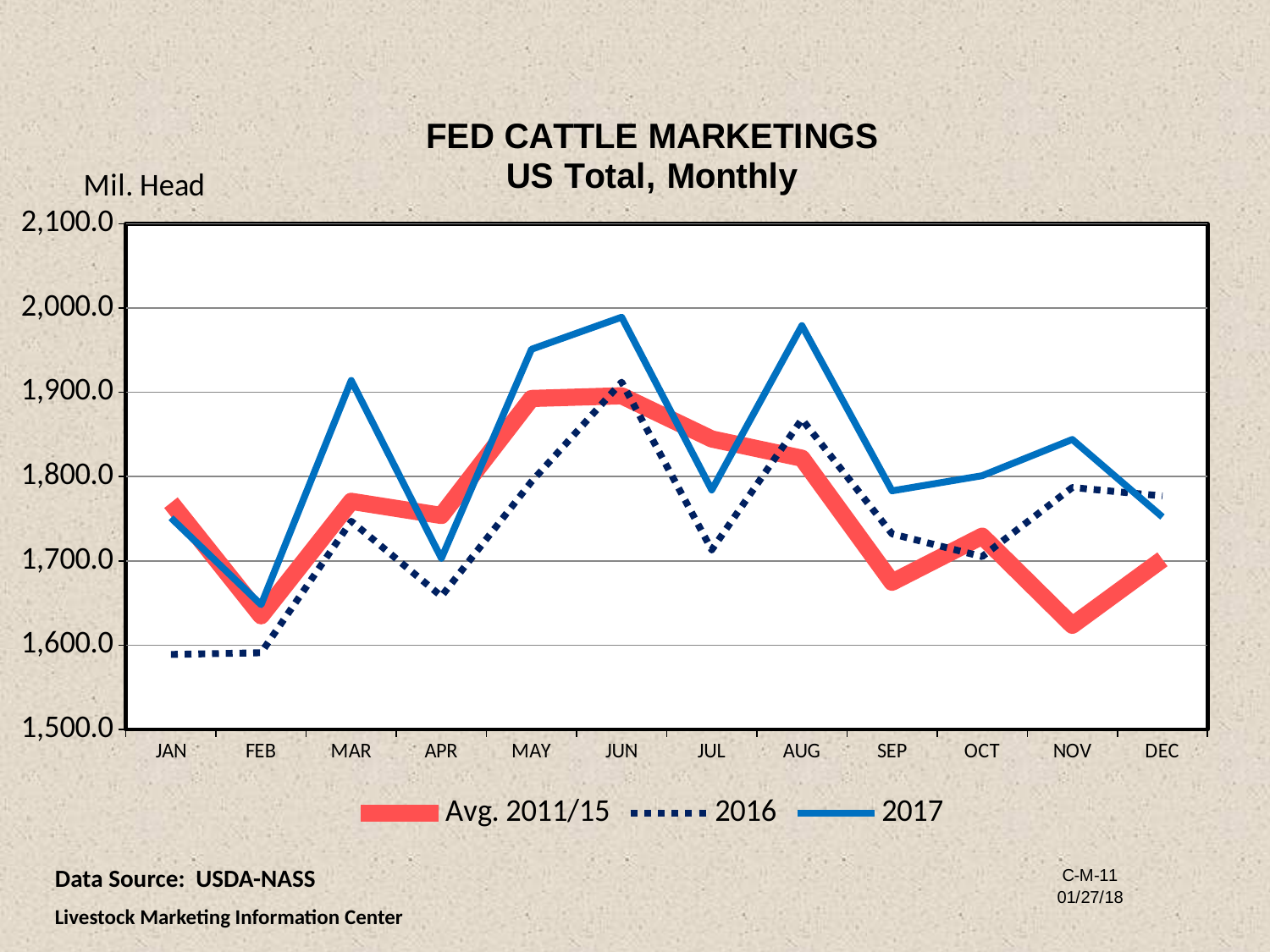
Does the Avg. 2011/15 line rise or fall from JUN to SEP? fall What is the label on the vertical axis? Mil. Head In AUG, which is larger: the 2017 value or the 2016 value? 2017 Is the 2017 value for JUN greater or less than 1,900.0? greater How many series does the legend list? 3 Is the 2016 value for APR greater or less than 1,700.0? less In which month is the 2017 line at its lowest? FEB How many months are shown along the x axis? 12 Is the 2016 value for JAN greater or less than 1,600.0? less In DEC, which is larger: the 2016 value or the Avg. 2011/15 value? 2016 What kind of chart is shown on the slide? Line chart Which series are listed in the legend? Avg. 2011/15, 2016, 2017